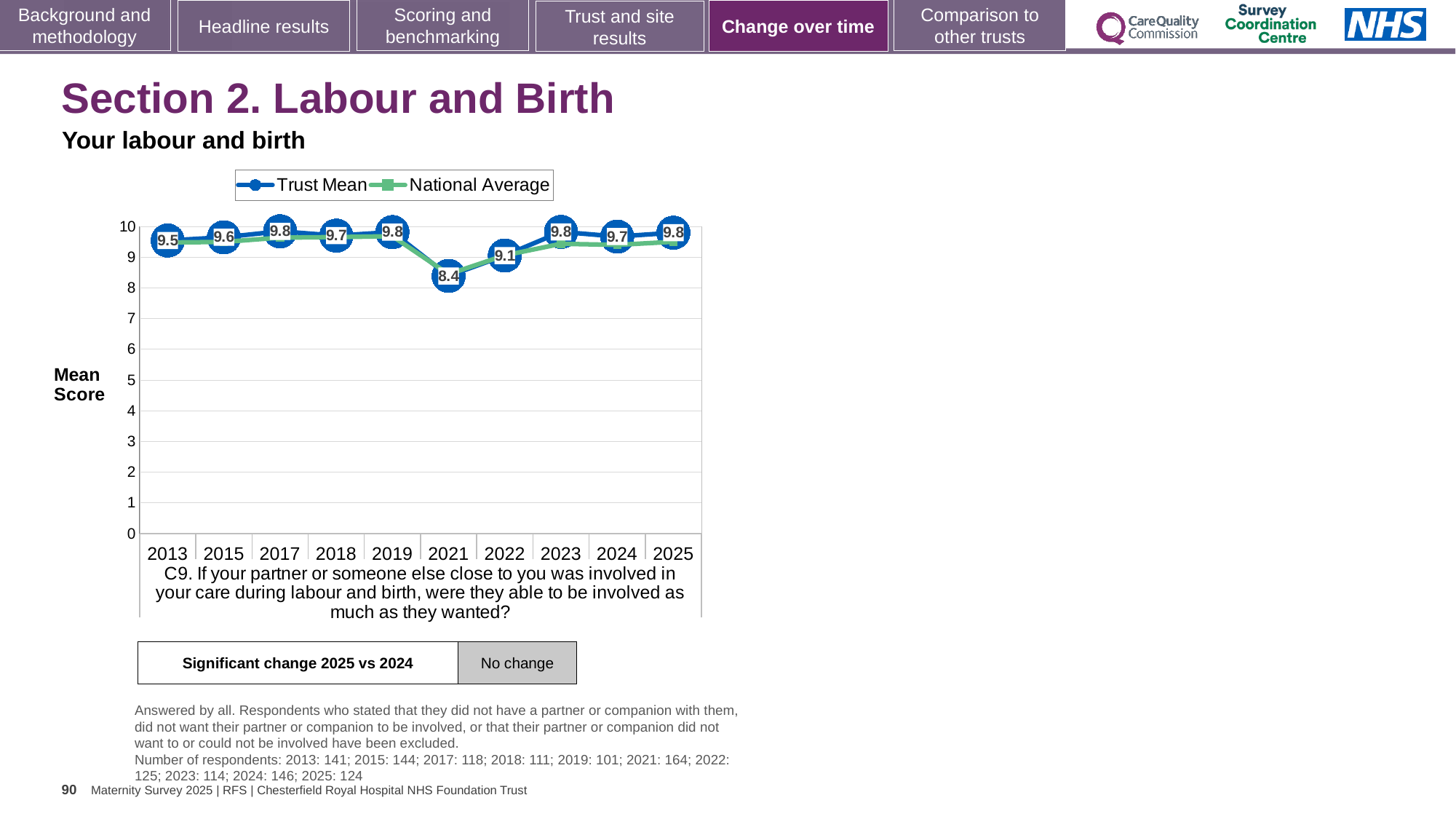
What is the Trust Mean for 2025? 9.8 How many years are shown on the x axis? 10 How many series does the legend list? 2 Does the Trust Mean rise or fall from 2021 to 2023? rise Is the Trust Mean for 2021 greater or less than 9? less What is the Trust Mean for 2021? 8.4 What kind of chart is shown? line chart What is the difference between the Trust Mean in 2022 and in 2021? 0.7 What is the Trust Mean for 2022? 9.1 Which year has the lowest Trust Mean? 2021 What is the Trust Mean for 2013? 9.5 Which is larger, the Trust Mean for 2024 or for 2025? 2025